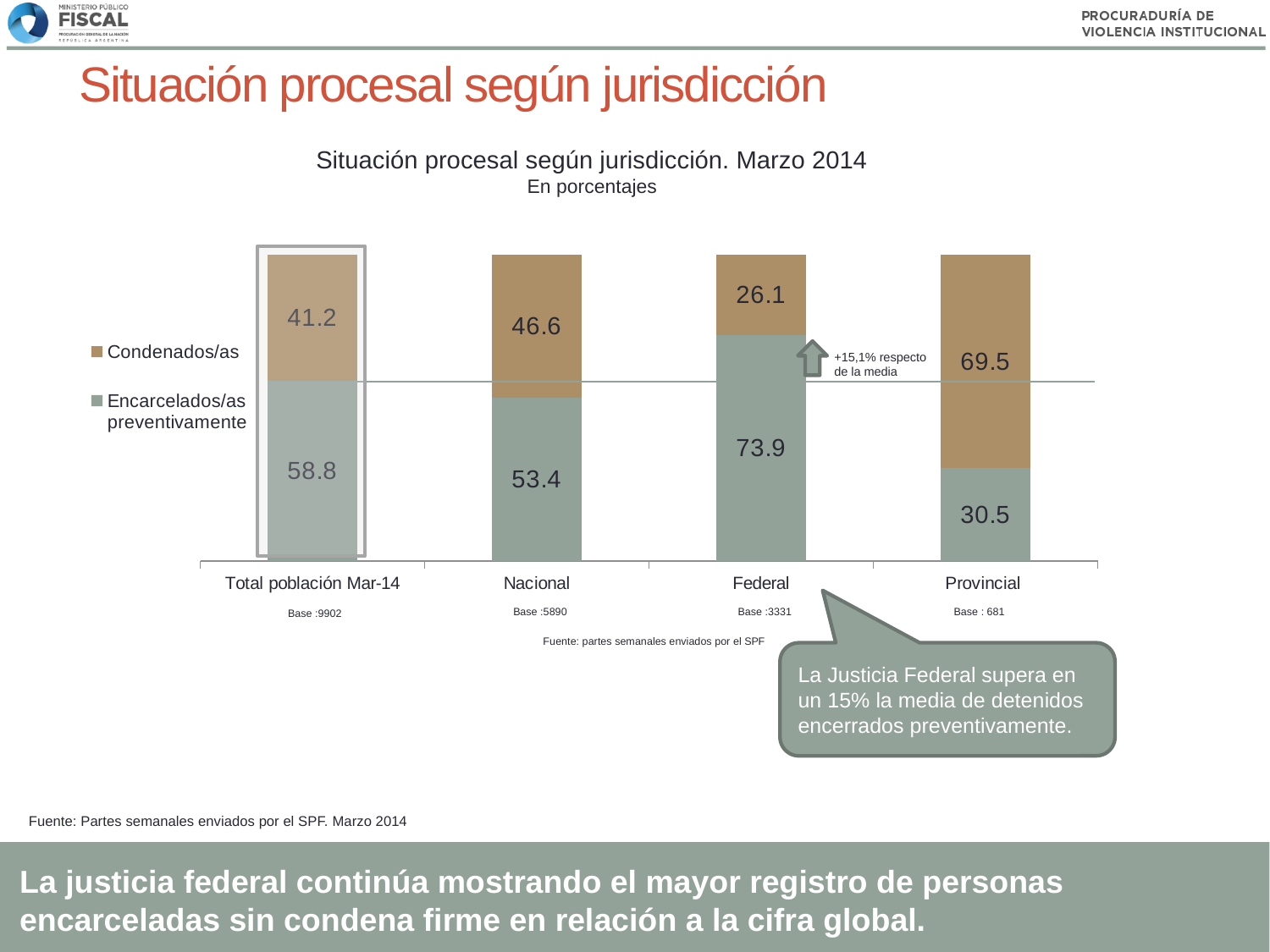
What is the total of the stacked bar for the Provincial category? 100 What is the value for Condenados/as in the Nacional category? 46.6 How many categories are shown on the x axis of the chart? 4 What is the value for Encarcelados/as preventivamente in the Total población Mar-14 category? 58.8 Which is larger: the Condenados/as value for Provincial or for Nacional? Provincial Which category has the lowest value for Condenados/as? Federal What is the value for Encarcelados/as preventivamente in the Federal category? 73.9 What is the difference between the Encarcelados/as preventivamente value for Federal and for Total población Mar-14? 15.1 Which category has the highest value for Encarcelados/as preventivamente? Federal What is the value for Condenados/as in the Provincial category? 69.5 How many series does the legend list? 2 What kind of chart is shown on the slide? Stacked bar chart